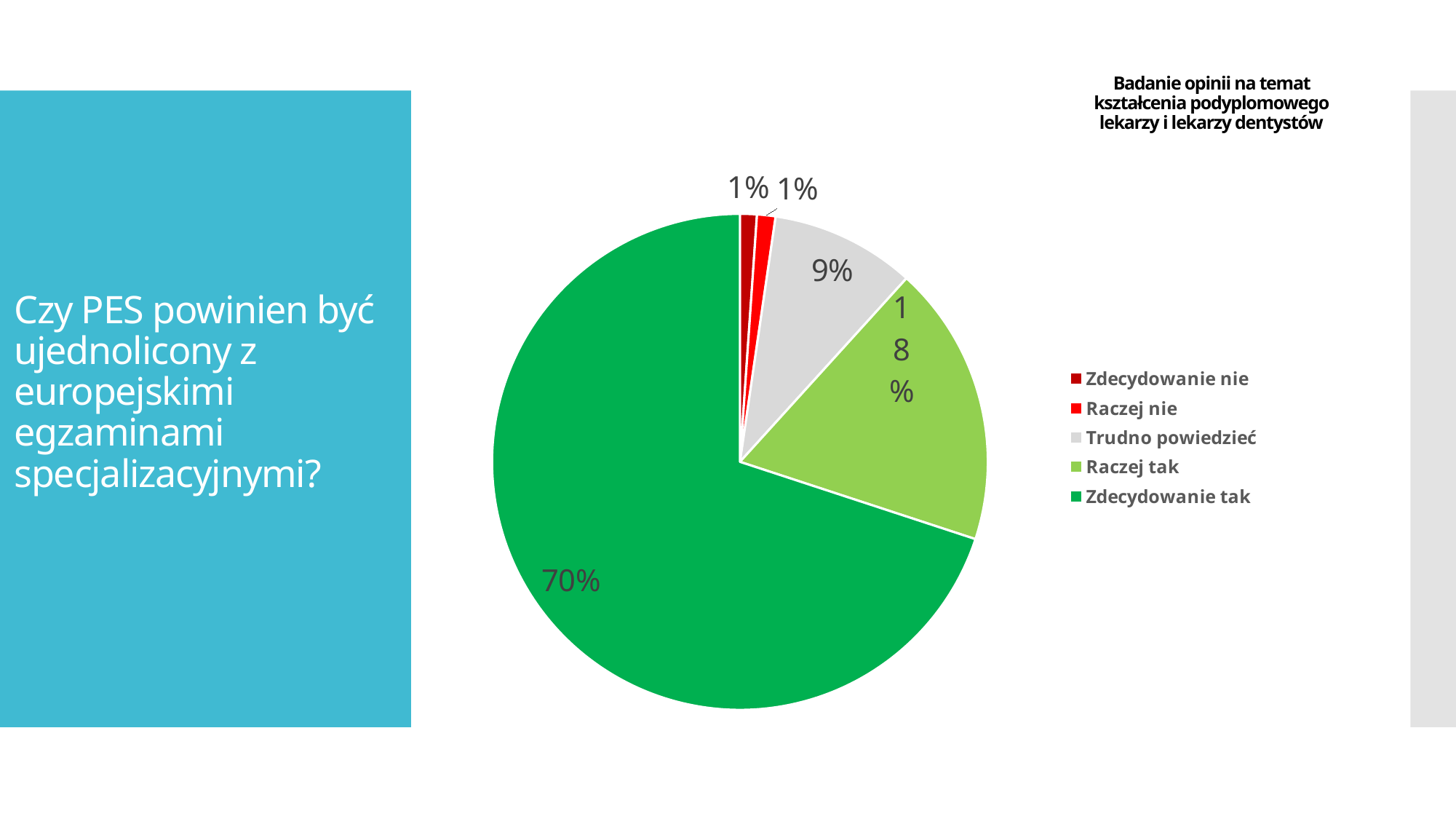
What is the value for "Trudno powiedzieć"? 9% What share of the pie does "Zdecydowanie tak" have? 70% How many categories does the legend list? 5 What is the combined value of "Raczej tak" and "Zdecydowanie tak"? 88% How many slices does the pie chart have? 5 Which is larger, the value for "Raczej tak" or the value for "Trudno powiedzieć"? Raczej tak What colour is the "Trudno powiedzieć" slice? grey Which category has the largest slice of the pie? Zdecydowanie tak What is the value for "Raczej nie"? 1% What is the difference between the values for "Zdecydowanie tak" and "Raczej tak"? 52% What kind of chart is shown on the slide? pie chart What is the value for "Raczej tak"? 18%